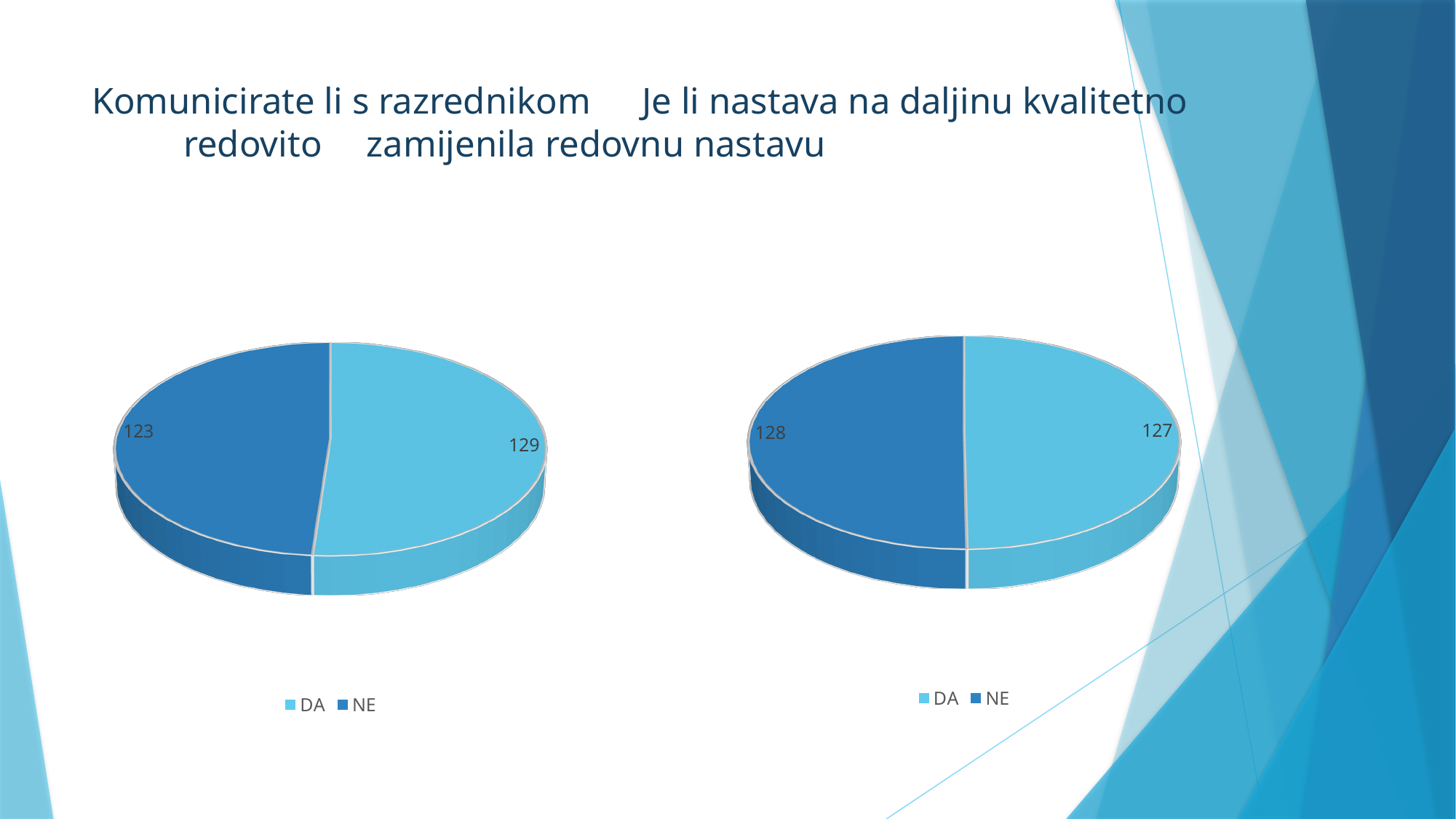
In the left pie chart (Komunicirate li s razrednikom redovito), what is the value for DA? 129 In the right pie chart (Je li nastava na daljinu kvalitetno zamijenila redovnu nastavu), what is the value for NE? 128 In the right pie chart (Je li nastava na daljinu kvalitetno zamijenila redovnu nastavu), what is the value for DA? 127 In the right pie chart (Je li nastava na daljinu kvalitetno zamijenila redovnu nastavu), which slice is larger, DA or NE? NE How many entries does the legend of the right pie chart list? 2 In the left pie chart (Komunicirate li s razrednikom redovito), what is the value for NE? 123 What type of chart is used on the left side of the slide? Pie chart In the left pie chart (Komunicirate li s razrednikom redovito), what is the total of the two slices? 252 In the left pie chart (Komunicirate li s razrednikom redovito), which slice is larger, DA or NE? DA In the left pie chart (Komunicirate li s razrednikom redovito), what is the difference between the DA and NE values? 6 In the right pie chart (Je li nastava na daljinu kvalitetno zamijenila redovnu nastavu), what is the total of the two slices? 255 In the right pie chart (Je li nastava na daljinu kvalitetno zamijenila redovnu nastavu), what is the difference between the NE and DA values? 1